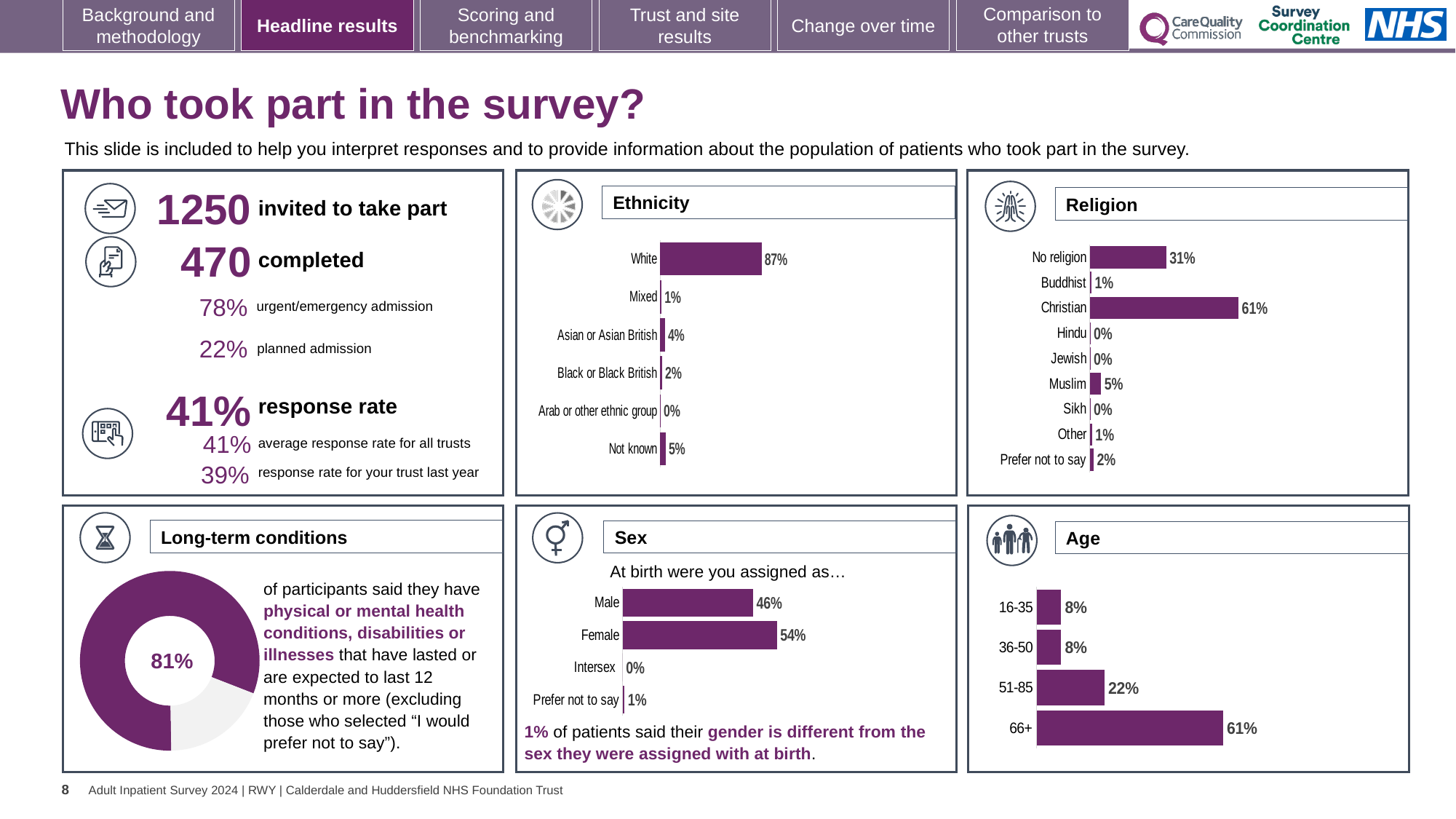
In the Religion chart, what is the difference between the Christian and No religion values? 30% What kind of chart is the Long-term conditions chart? doughnut chart In the Religion chart, what percentage of respondents were Christian? 61% In the Religion chart, how many categories are shown? 9 In the Sex chart, what percentage of respondents were Female? 54% In the Ethnicity chart, how many categories are shown? 6 In the Ethnicity chart, which category has the highest value? White In the Age chart, what is the difference between the 66+ and 51-85 values? 39% In the Age chart, do the values rise or fall as age increases from 16-35 to 66+? rise In the Age chart, what percentage of respondents were aged 66+? 61% In the Ethnicity chart, what percentage of respondents were White? 87% In the Sex chart, which is larger, Male or Female? Female